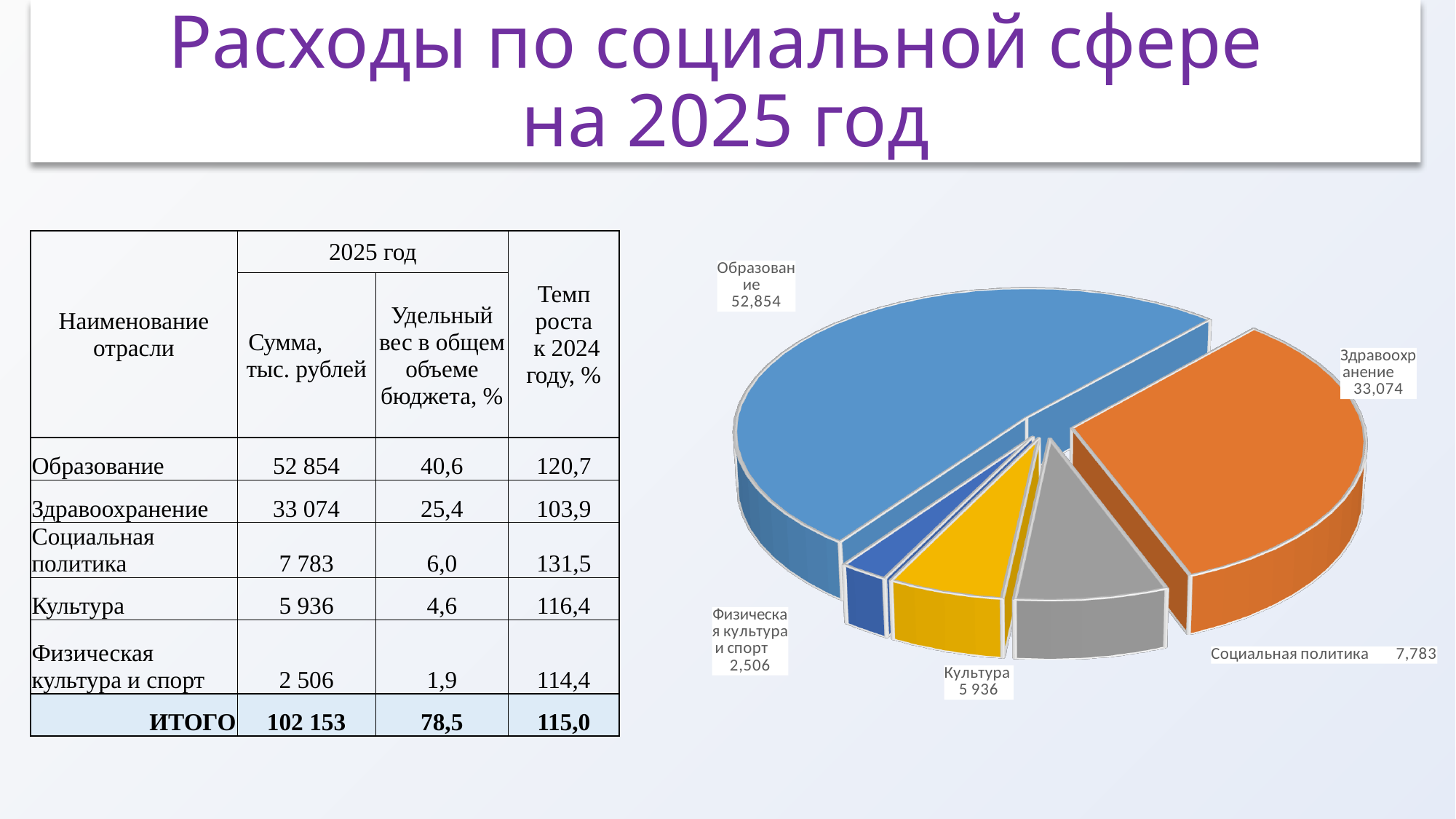
In the pie chart, what value is shown for Здравоохранение? 33,074 In the pie chart, what is the difference between the values for Образование and Здравоохранение? 19,780 Which slice of the pie chart has the largest value? Образование In the pie chart, what value is shown for Образование? 52,854 In the pie chart, what value is shown for Физическая культура и спорт? 2,506 In the pie chart, what value is shown for Культура? 5 936 In the pie chart, what value is shown for Социальная политика? 7,783 In the pie chart, which is larger: Здравоохранение or Социальная политика? Здравоохранение Which slice of the pie chart has the smallest value? Физическая культура и спорт What type of chart is shown on the slide? Pie chart How many slices does the pie chart have? 5 What colour is the Здравоохранение slice in the pie chart? Orange